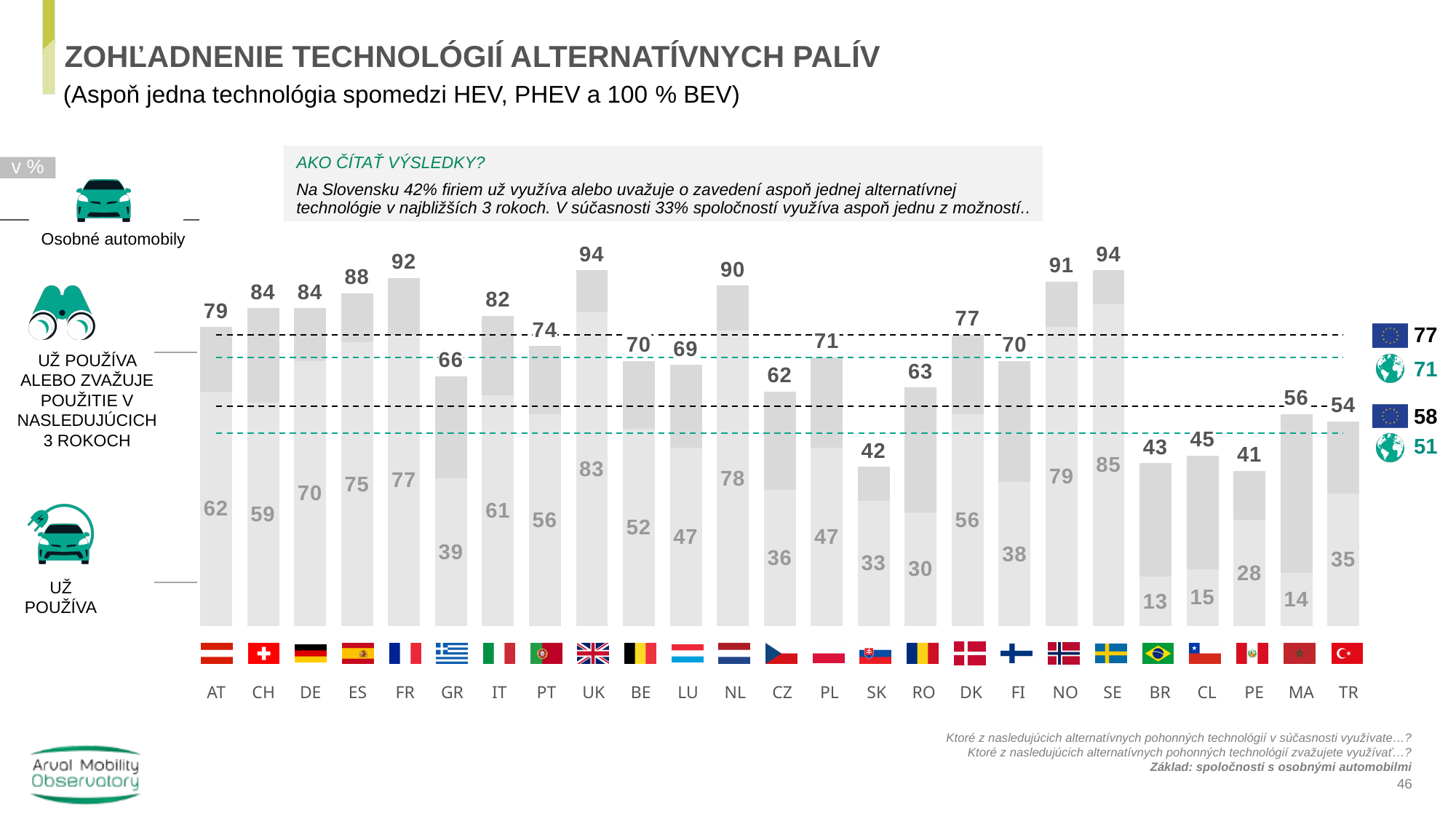
Which country has the highest value in the 'Už používa' series? SE What is the EU reference value shown for the 'Už používa alebo zvažuje použitie v nasledujúcich 3 rokoch' series? 77 What is the world reference value shown for the 'Už používa' series? 51 What is the value for FR in the 'Už používa' series? 77 What is the value for SK in the 'Už používa alebo zvažuje použitie v nasledujúcich 3 rokoch' series? 42 What is the difference between the 'Už používa alebo zvažuje' value and the 'Už používa' value for GR? 27 What kind of chart is shown on the slide? bar chart Which is larger: the 'Už používa' value for DE or for ES? ES How many countries are shown on the x axis of the chart? 25 Which country has the lowest value in the 'Už používa' series? BR Which country has the lowest value in the 'Už používa alebo zvažuje použitie v nasledujúcich 3 rokoch' series? PE What is the 'Už používa' value for NL? 78